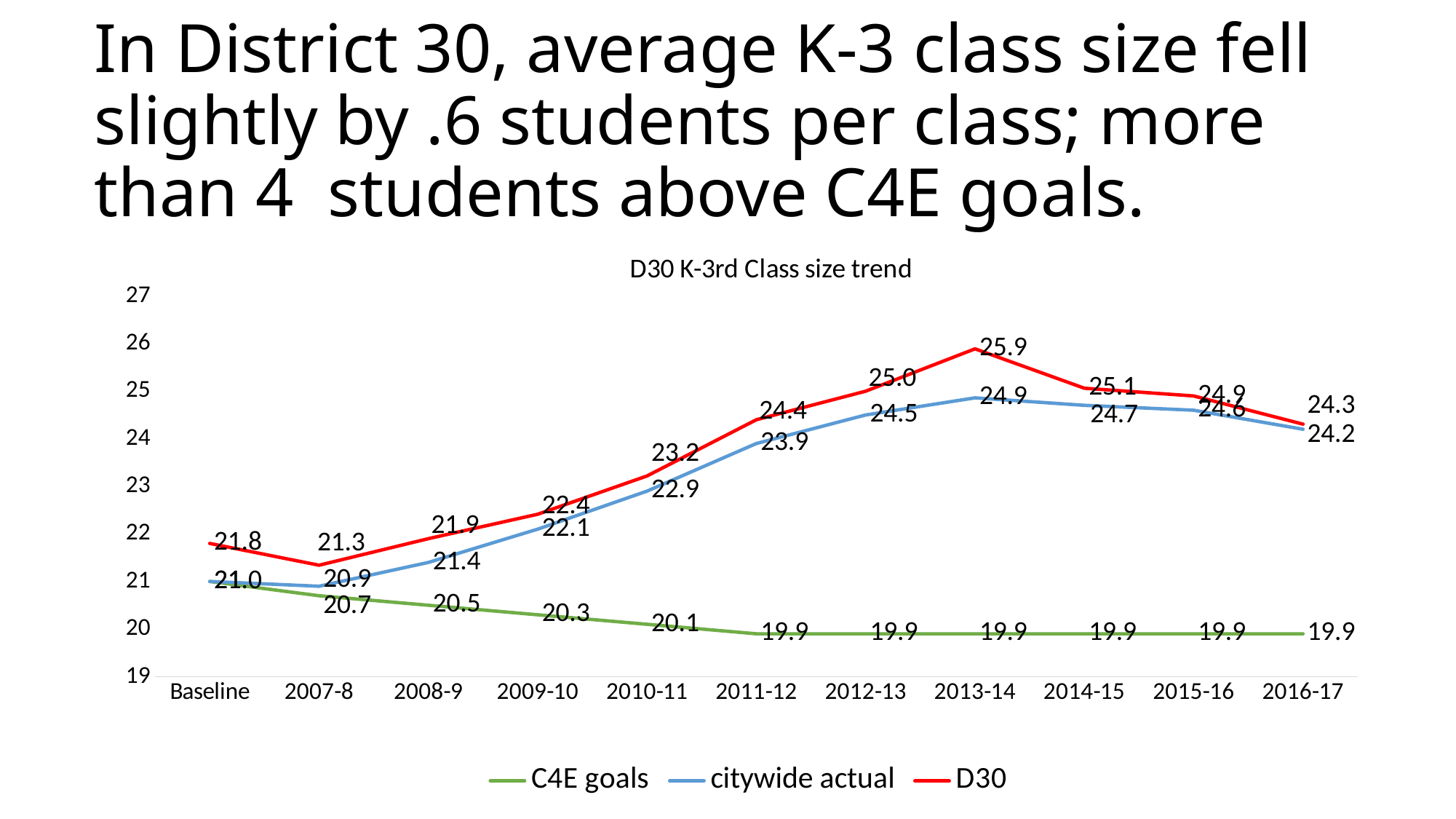
In which year does the D30 series reach its highest value? 2013-14 What is the difference between the D30 value and the C4E goals value in 2016-17? 4.4 What is the citywide actual value for 2016-17? 24.2 What kind of chart is shown? Line chart What is the D30 value for 2013-14? 25.9 How many series does the legend list? 3 In which year is the D30 series at its lowest value? 2007-8 How many points are plotted along the x axis? 11 Does the C4E goals series rise or fall from Baseline to 2016-17? Fall What is the D30 value at Baseline? 21.8 What is the C4E goals value for 2009-10? 20.3 In 2014-15, which is larger: the D30 value or the citywide actual value? D30